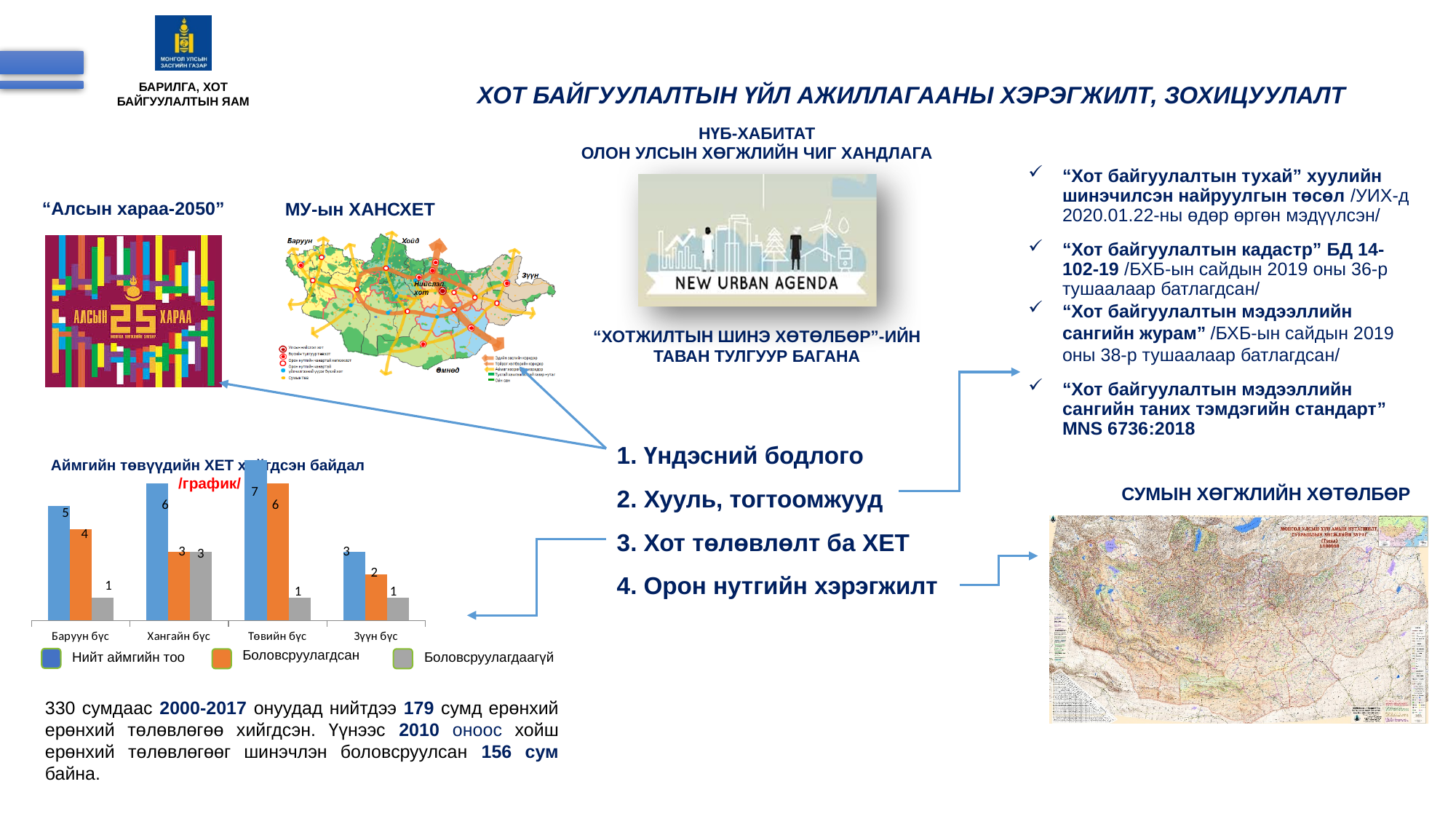
Which region has the lowest value for "Нийт аймгийн тоо" in the bar chart? Зүүн бүс What kind of chart is shown under the title "Аймгийн төвүүдийн ХЭТ хийгдсэн байдал"? bar chart In the bar chart, which is larger for Зүүн бүс: "Боловсруулагдсан" or "Боловсруулагдаагүй"? Боловсруулагдсан What colour are the "Боловсруулагдсан" bars in the bar chart? orange Which region has the highest value for "Нийт аймгийн тоо" in the bar chart? Төвийн бүс In the bar chart, what is the difference between "Нийт аймгийн тоо" and "Боловсруулагдсан" for Хангайн бүс? 3 What is the value of "Боловсруулагдаагүй" for Хангайн бүс in the bar chart? 3 How many series does the legend of the bar chart list? 3 How many region categories are shown on the x axis of the bar chart? 4 What is the value of "Боловсруулагдсан" for Баруун бүс in the bar chart? 4 Which region has the highest value for "Боловсруулагдсан" in the bar chart? Төвийн бүс What is the value of "Нийт аймгийн тоо" for Төвийн бүс in the bar chart? 7